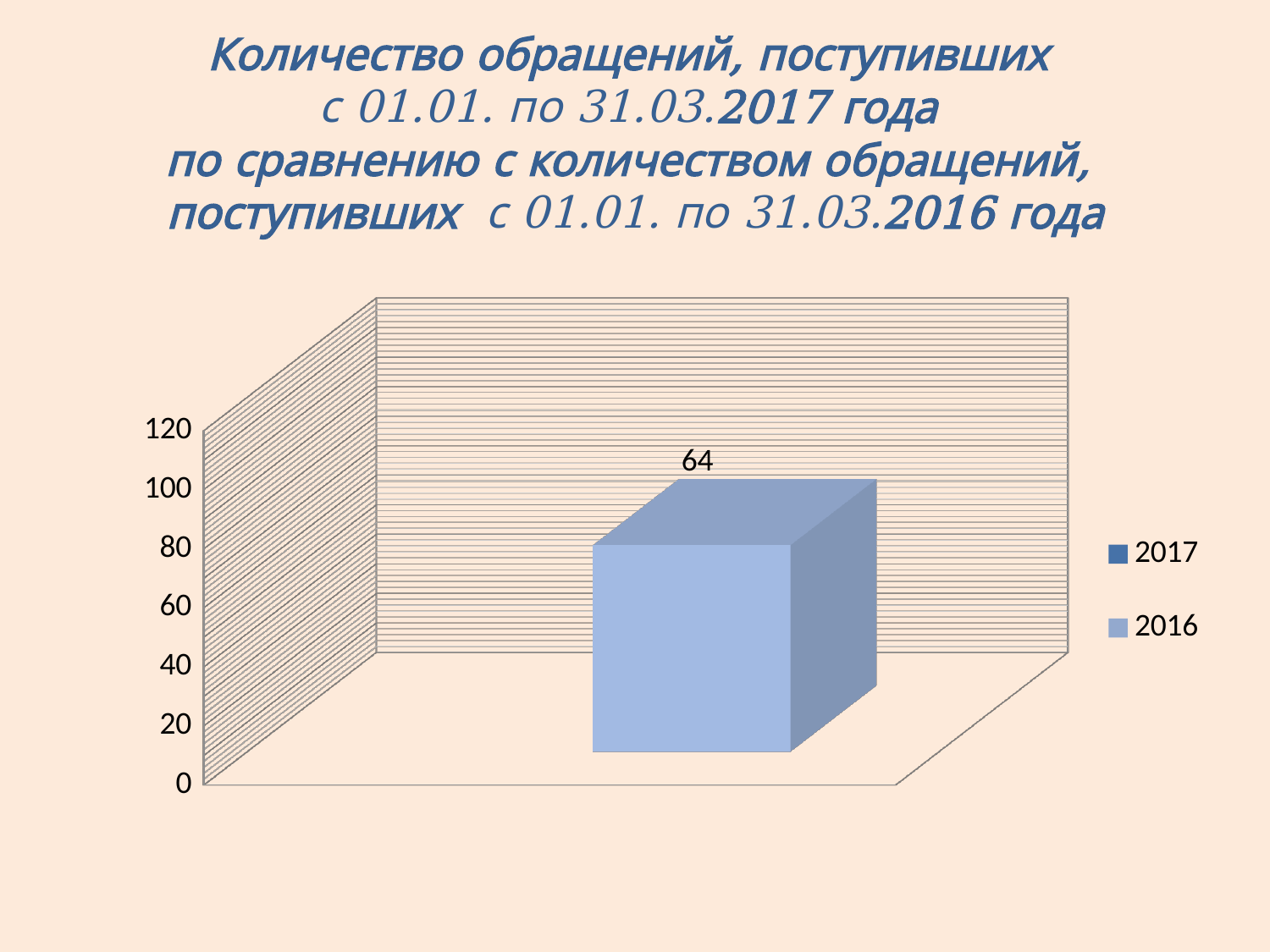
What kind of chart is shown on the slide? bar chart What is the highest value shown on the vertical axis of the chart? 120 Is the value of the bar labelled 64 greater or less than 60? greater Is the value of the bar labelled 64 greater or less than 80? less How many series does the legend of the chart list? 2 What are the two entries listed in the chart's legend? 2017 and 2016 How many bars are visible in the chart? 1 What is the value shown for the 2016 series in the chart? 64 What value is printed on the data label of the bar in the chart? 64